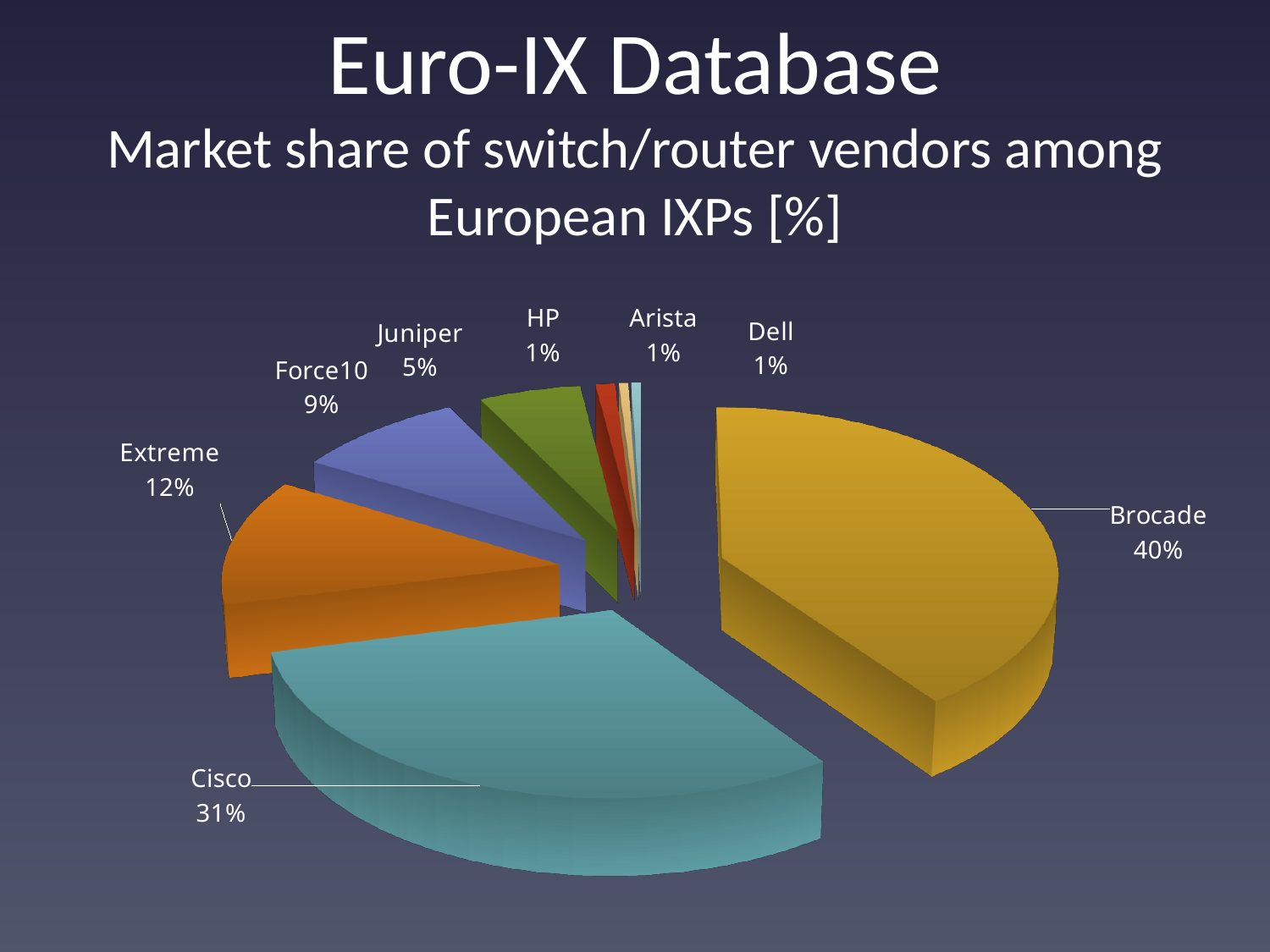
What is the combined market share of Brocade and Cisco? 71% Which has a larger market share, Extreme or Force10? Extreme How many vendors are shown in the pie chart? 8 What is the title of the chart? Euro-IX Database Market share of switch/router vendors among European IXPs [%] What is the market share of Juniper? 5% What is the market share of Brocade? 40% What kind of chart is shown on the slide? Pie chart What is the market share of Cisco? 31% Which vendor has the largest market share? Brocade What is the market share of Extreme? 12% What is the market share of Force10? 9% What is the difference in market share between Brocade and Cisco? 9%